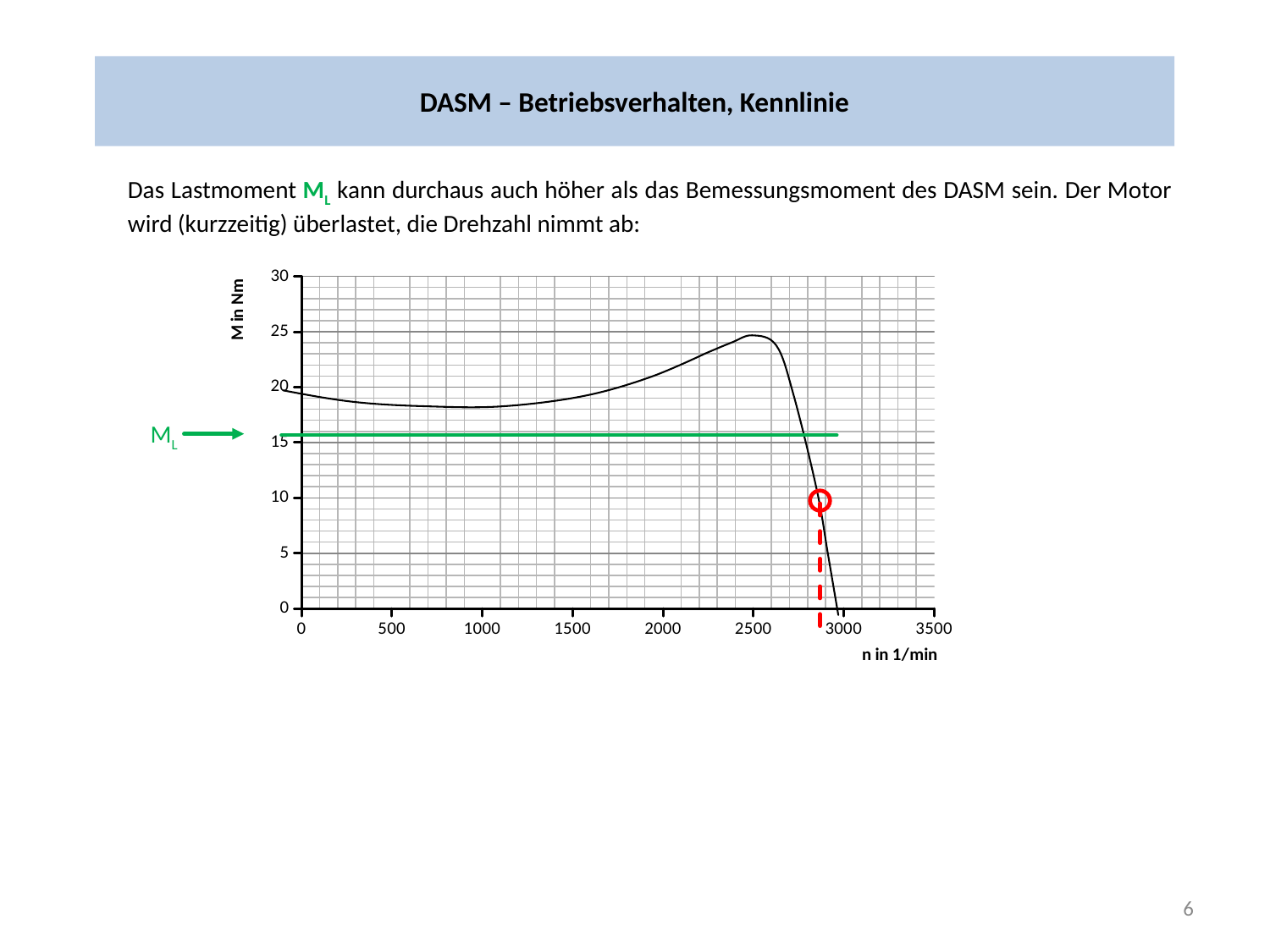
Is the value of the curve at n = 1000 greater or less than 20? less Is the value of the curve at n = 2500 greater or less than 20? greater What is the label of the vertical axis of the chart? M in Nm Is the green M_L line greater or less than 20 Nm? less What is the label of the horizontal axis of the chart? n in 1/min Does the curve rise or fall between n = 2500 and n = 3000? fall What kind of chart is shown on the slide? line chart Is the curve value at n = 2500 larger or smaller than at n = 1000? larger Does the curve rise or fall between n = 1000 and n = 2500? rise